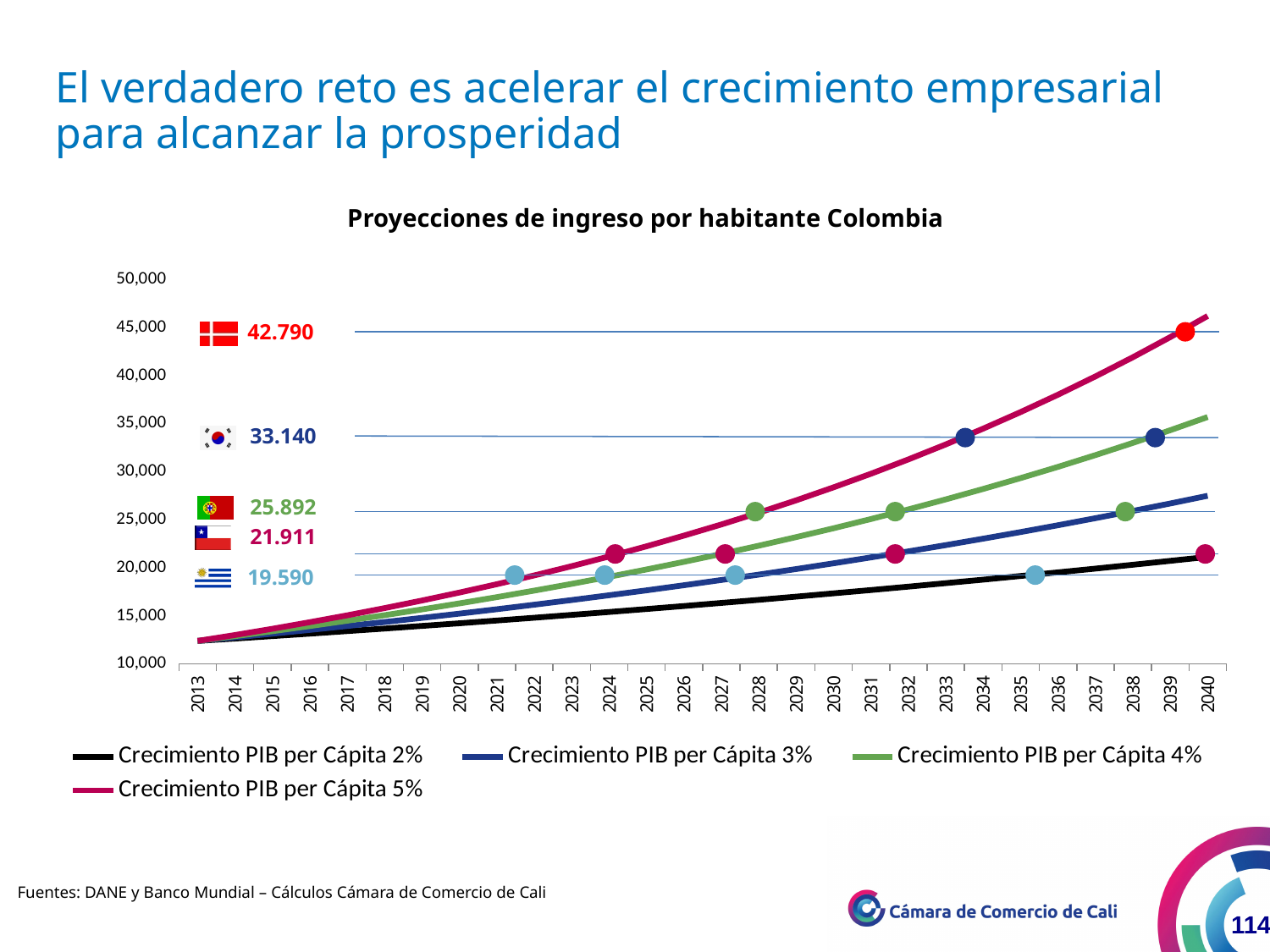
How many series does the legend list? 4 What value is labelled next to the Danish flag on the chart? 42.790 What is the title of the chart? Proyecciones de ingreso por habitante Colombia In 2040, which is larger: the Crecimiento PIB per Cápita 3% series or the Crecimiento PIB per Cápita 4% series? Crecimiento PIB per Cápita 4% Which series reaches the highest value in 2040? Crecimiento PIB per Cápita 5% Which series has the lowest value in 2040? Crecimiento PIB per Cápita 2% Is the value of the Crecimiento PIB per Cápita 2% series in 2040 greater or less than 25,000? less Is the value of the Crecimiento PIB per Cápita 5% series in 2040 greater or less than 45,000? greater Is the value of the Crecimiento PIB per Cápita 4% series in 2040 greater or less than 30,000? greater What kind of chart is shown on the slide? line chart Do the values of the Crecimiento PIB per Cápita 5% series rise or fall from 2013 to 2040? rise What is the first year shown on the x axis? 2013